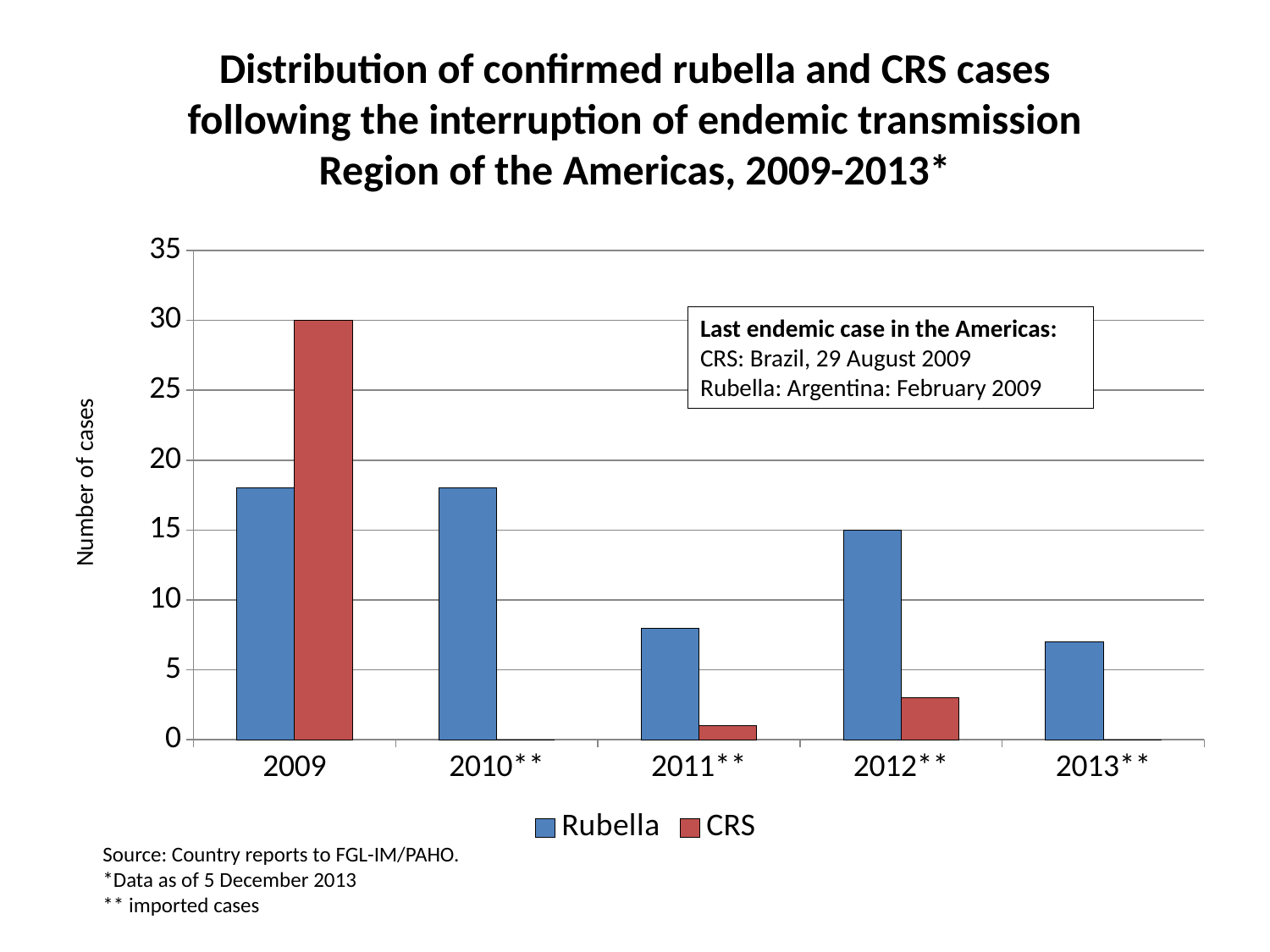
In 2009, which is larger, the Rubella value or the CRS value? CRS What is the number of CRS cases in 2009? 30 Is the Rubella value for 2011** greater or less than 10? less Is the CRS value for 2012** greater or less than 5? less How many years are shown on the x axis? 5 How many series does the legend list? 2 Is the Rubella value for 2009 greater or less than 20? less What kind of chart is shown on the slide? bar chart In 2012**, which is larger, the Rubella value or the CRS value? Rubella What is the number of Rubella cases in 2012**? 15 Which colour represents the CRS series in the legend? red In which year is the CRS value highest? 2009